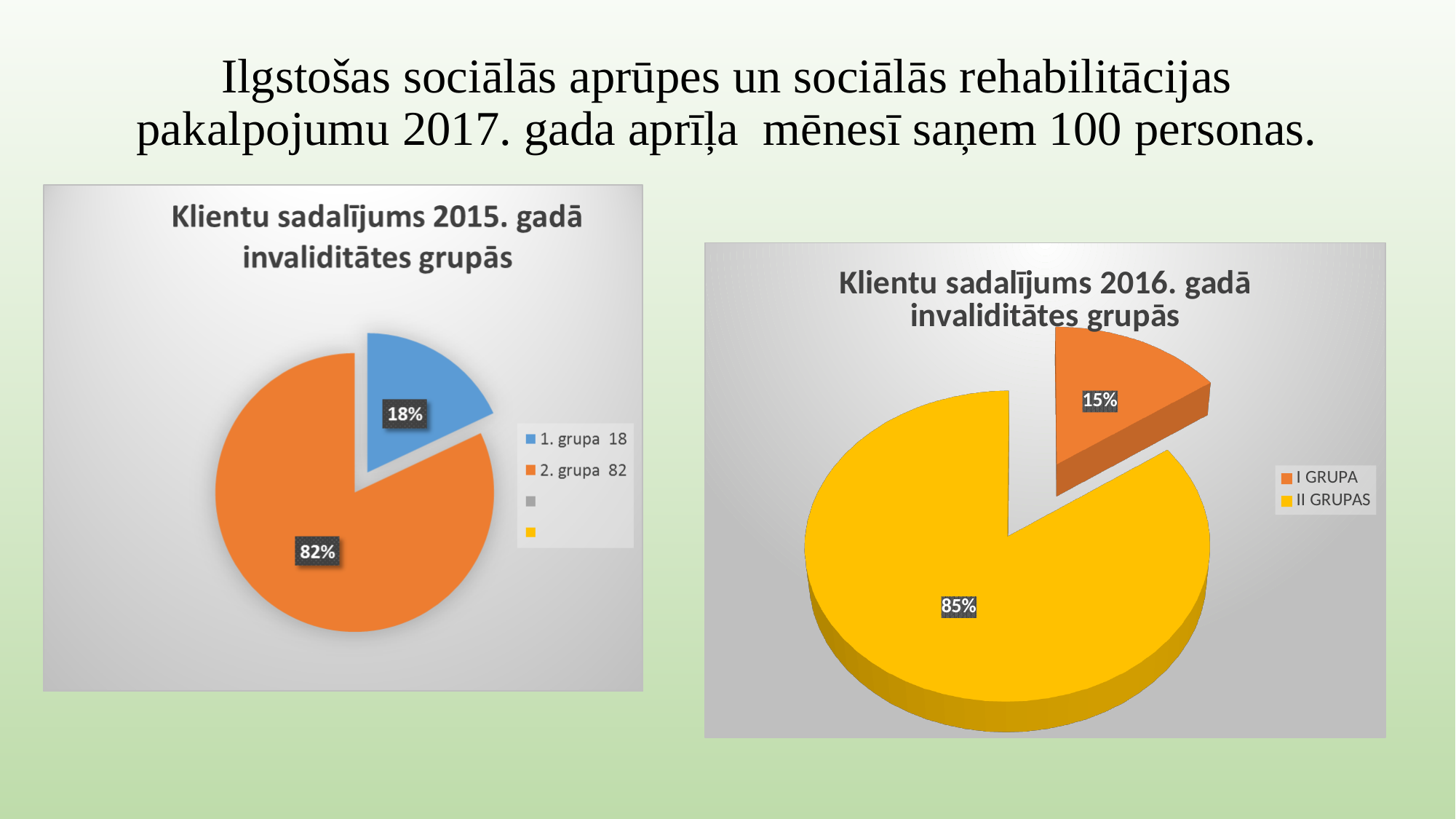
In the chart on the right, which group has the smallest slice? I GRUPA In the chart titled "Klientu sadalījums 2015. gadā invaliditātes grupās", what percentage is shown for 2. grupa? 82% What type of chart is the chart on the right? Pie chart In the chart on the left, what is the difference in percentage points between 2. grupa and 1. grupa? 64 In the chart on the left, what number is shown next to "1. grupa" in the legend? 18 In the chart titled "Klientu sadalījums 2016. gadā invaliditātes grupās", what percentage is shown for I GRUPA? 15% In the chart on the right, what is the difference in percentage points between II GRUPAS and I GRUPA? 70 Which is larger in the chart on the right: the slice for I GRUPA or the slice for II GRUPAS? II GRUPAS In the chart titled "Klientu sadalījums 2015. gadā invaliditātes grupās", what percentage is shown for 1. grupa? 18% What colour is the II GRUPAS slice in the chart on the right? Yellow In the chart titled "Klientu sadalījums 2016. gadā invaliditātes grupās", what percentage is shown for II GRUPAS? 85% In the chart on the left, which group has the largest slice? 2. grupa